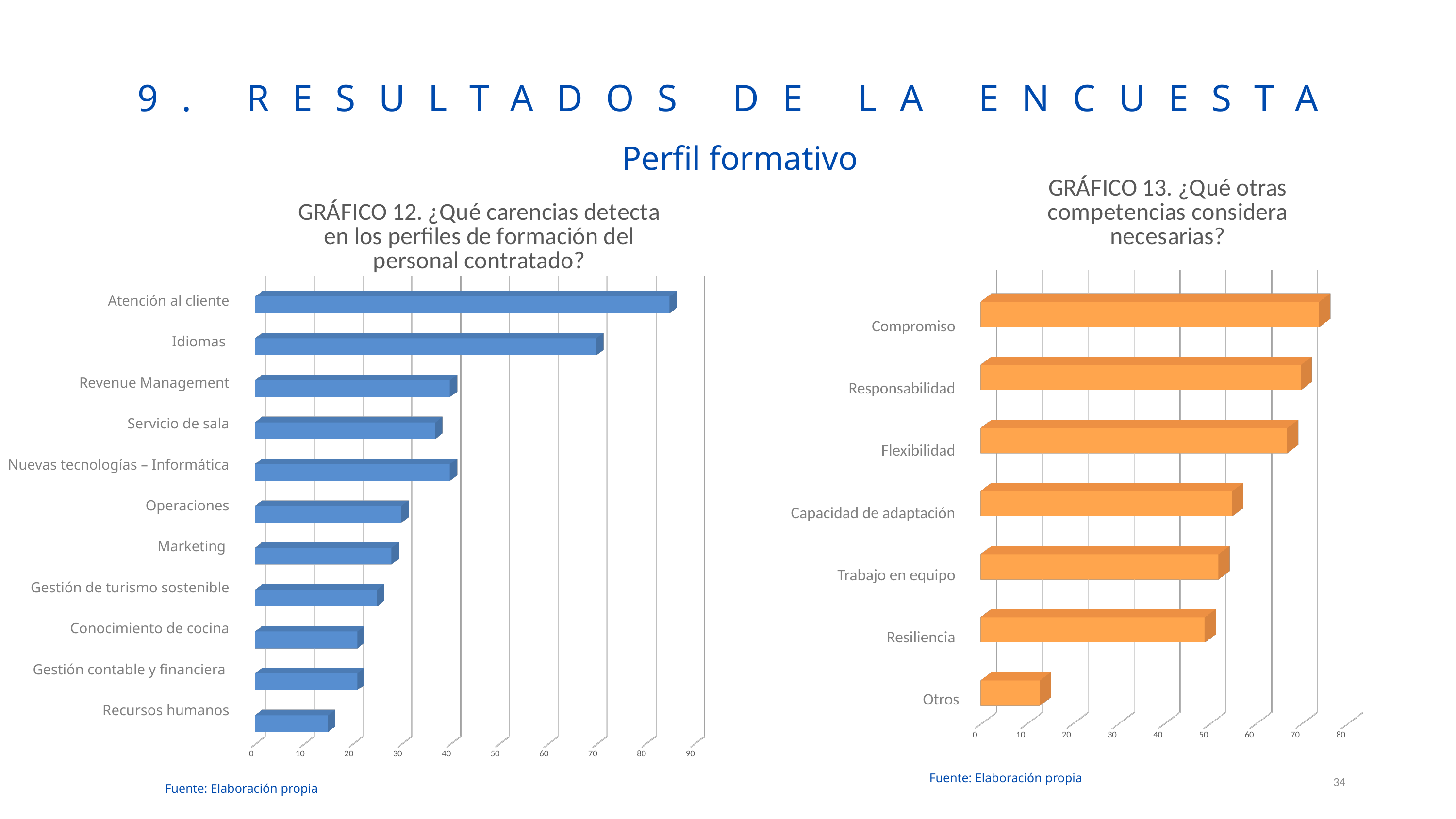
In GRÁFICO 13, is the value for Resiliencia greater or less than 40? greater In GRÁFICO 13, which category has the lowest value? Otros In GRÁFICO 13, which category has the highest value? Compromiso In GRÁFICO 12, how many categories are plotted? 11 In GRÁFICO 12, which category has the lowest value? Recursos humanos In GRÁFICO 12, what kind of chart is shown? bar chart In GRÁFICO 12, which is larger, the value for Operaciones or the value for Gestión de turismo sostenible? Operaciones In GRÁFICO 12, which category has the highest value? Atención al cliente In GRÁFICO 12, is the value for Idiomas greater or less than 60? greater In GRÁFICO 13, how many categories are plotted? 7 In GRÁFICO 13, what colour are the bars? orange In GRÁFICO 12, is the value for Recursos humanos greater or less than 20? less